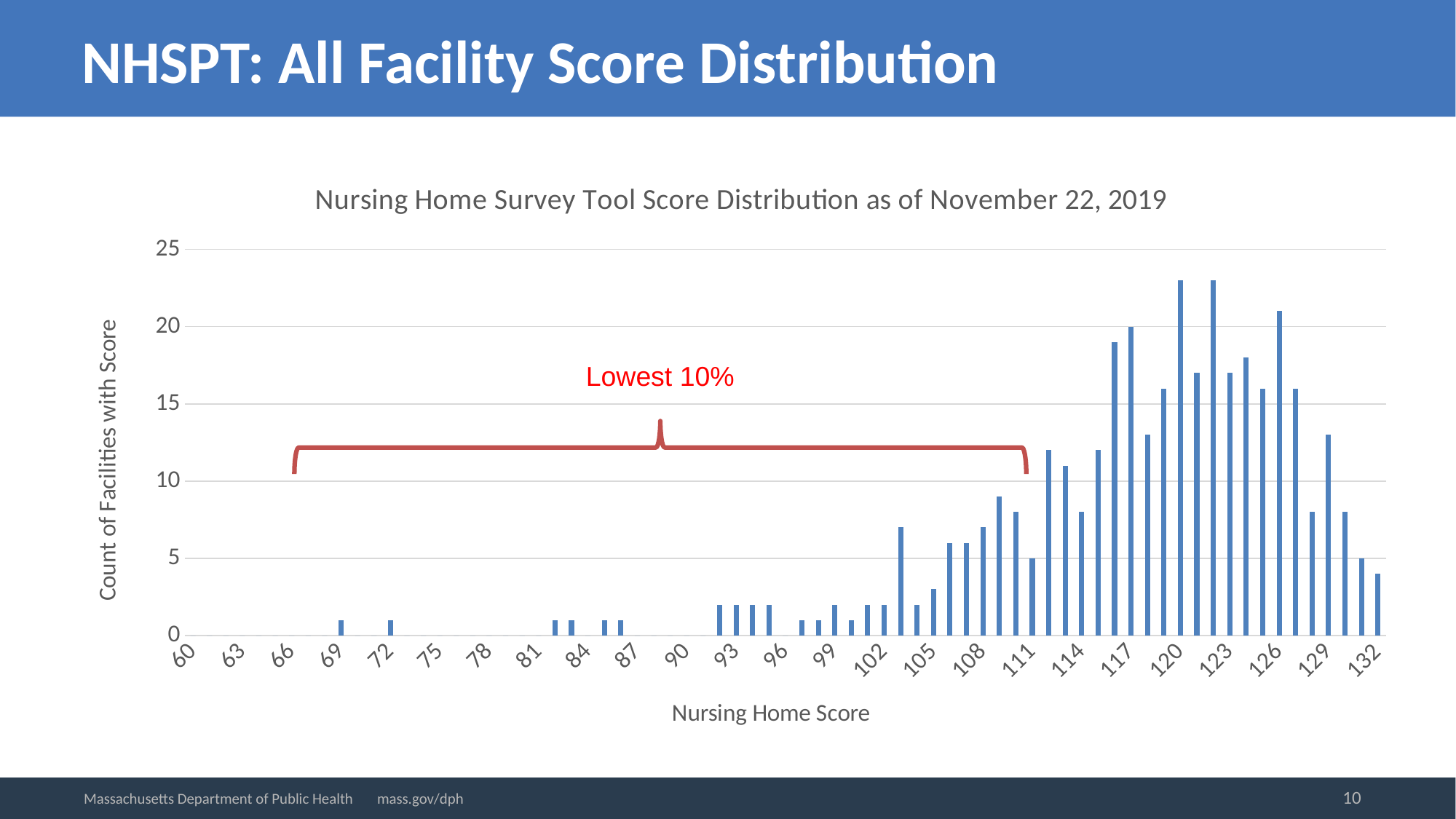
How many facilities have a score of 117? 20 Which score has more facilities, 126 or 129? 126 What kind of chart is shown on the slide? bar chart What does the red bracket annotation on the chart label? Lowest 10% Is the count of facilities with a score of 132 greater or less than 5? less How many facilities have a score of 111? 5 Is the count of facilities with a score of 105 greater or less than 5? less Which score has more facilities, 114 or 117? 117 Is the count of facilities with a score of 129 greater or less than 10? greater Do the counts generally rise or fall as the score increases from 102 to 120? rise What is the title of the chart? Nursing Home Survey Tool Score Distribution as of November 22, 2019